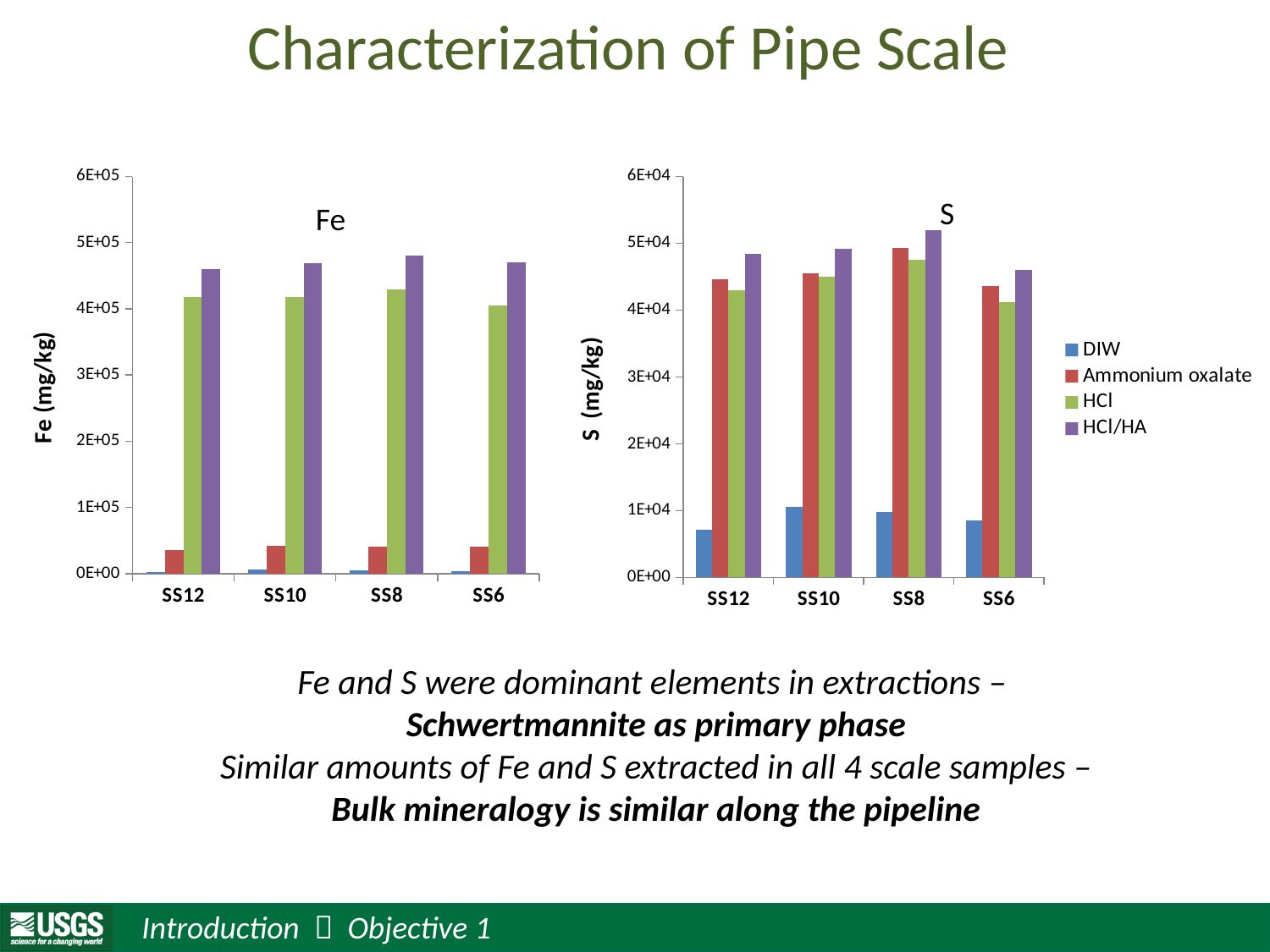
In the S chart, is the DIW value for SS12 greater or less than 1E+04? less What kind of chart is the Fe chart on the left? bar chart In the Fe chart, is the Ammonium oxalate value for SS10 greater or less than 1E+05? less In the S chart, which sample has the highest HCl/HA value? SS8 How many series does the legend list? 4 In the Fe chart, which series has the lowest values across all samples? DIW In the Fe chart, is the HCl/HA value for SS8 greater or less than 4E+05? greater What colour represents the HCl series in the legend? green In the S chart, which is larger for SS12: the DIW value or the HCl value? HCl In the Fe chart, which is larger for SS12: the HCl/HA value or the Ammonium oxalate value? HCl/HA How many sample categories are shown on the x axis of the S chart? 4